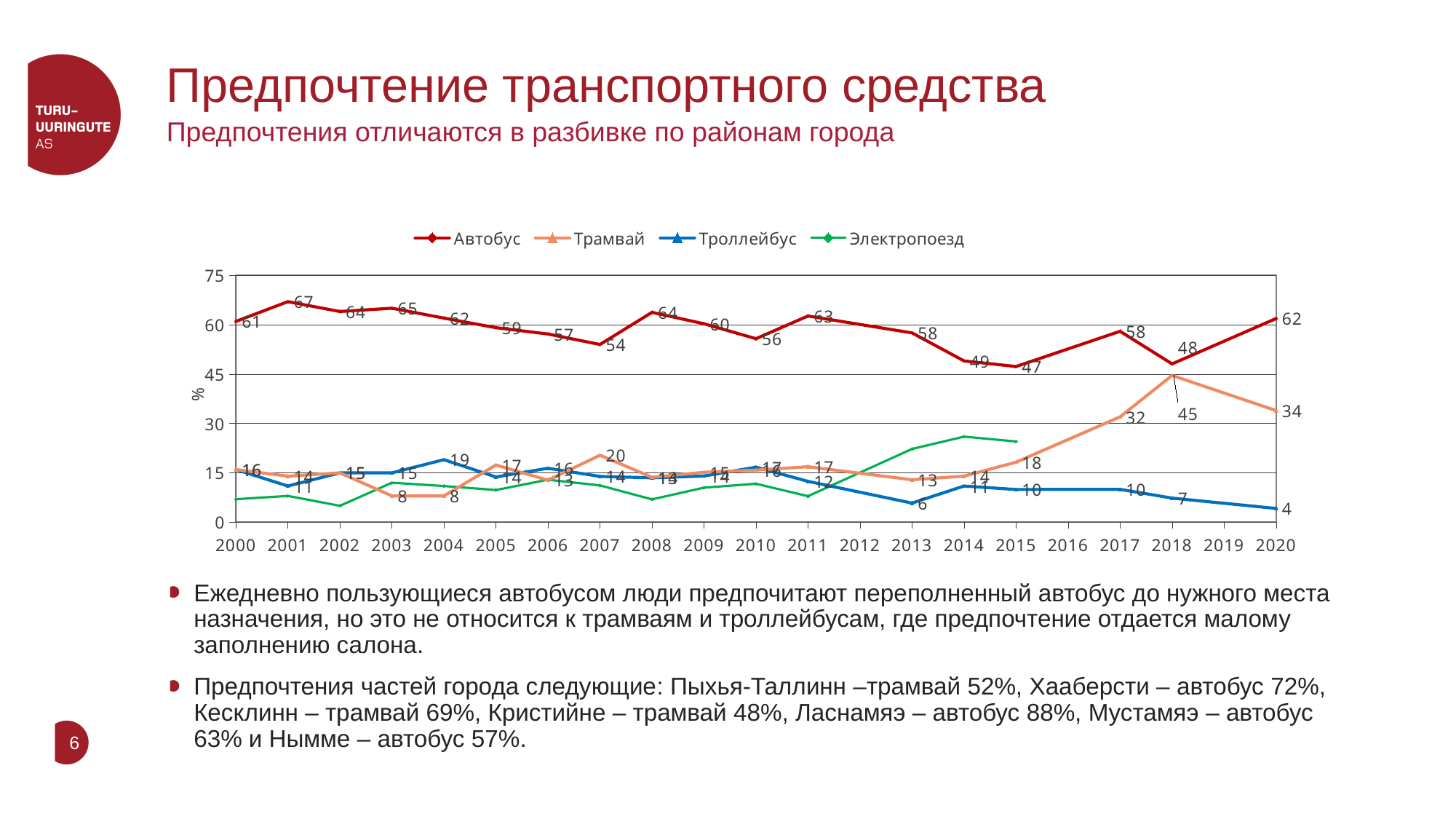
What is the value for Автобус in 2001? 67 What kind of chart is shown on the slide? line chart What is the value for Троллейбус in 2020? 4 Which series is drawn in green in the legend? Электропоезд In which year does the Автобус series reach its highest value? 2001 In 2018, which is larger: the Трамвай value or the Троллейбус value? Трамвай What is the difference between the Автобус and Трамвай values in 2020? 28 How many series does the legend list? 4 Does the Троллейбус series rise or fall between 2011 and 2020? fall In which year does the Автобус series reach its lowest value? 2015 Is the value for Электропоезд in 2015 greater or less than 30? less What is the value for Трамвай in 2018? 45